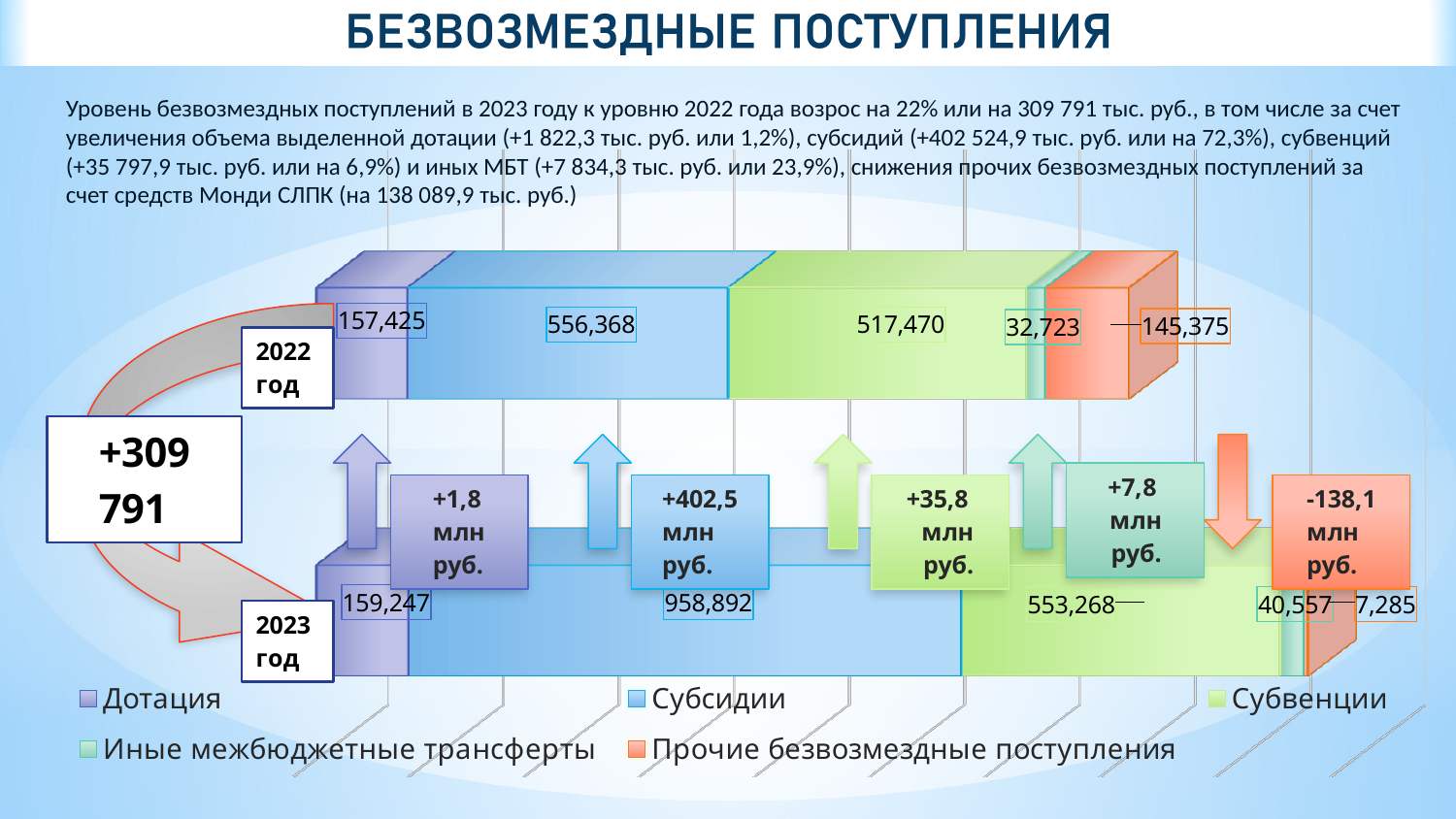
What is the value of Субсидии for 2022 год? 556,368 What is the difference between the Субсидии values for 2023 год and 2022 год? 402,524 How many bars (years) are plotted in the chart? 2 Which series has the smallest value in the 2023 год bar? Прочие безвозмездные поступления Which legend entry is shown in orange? Прочие безвозмездные поступления What type of chart is shown on the slide? Stacked bar chart What is the value of Прочие безвозмездные поступления for 2023 год? 7,285 What is the value of Субсидии for 2023 год? 958,892 How many series does the legend list? 5 Which is larger: Прочие безвозмездные поступления in 2022 год or in 2023 год? 2022 год What is the value of Иные межбюджетные трансферты for 2022 год? 32,723 Which series has the largest value in the 2023 год bar? Субсидии